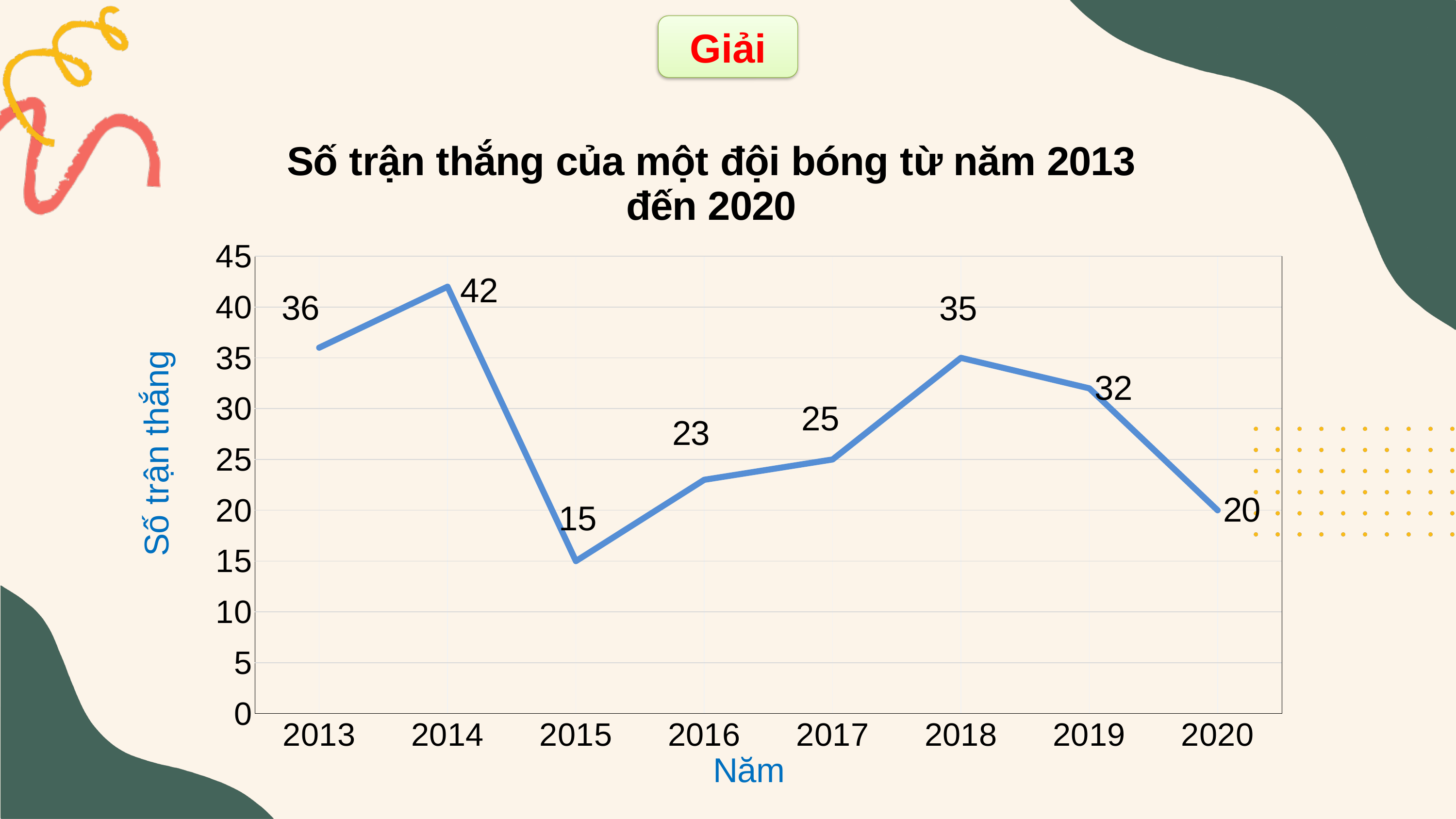
Which year had more wins, 2013 or 2018? 2013 Is the value for 2016 greater or less than 25? less How many wins did the team have in 2014? 42 What is the label of the vertical axis? Số trận thắng What is the value plotted for 2017? 25 Do the values rise or fall from 2018 to 2020? fall Which year has the lowest number of wins? 2015 What is the difference between the number of wins in 2014 and in 2015? 27 Which year has the highest number of wins? 2014 What kind of chart is shown on the slide? line chart What is the difference between the values for 2018 and 2019? 3 How many years are plotted on the chart? 8